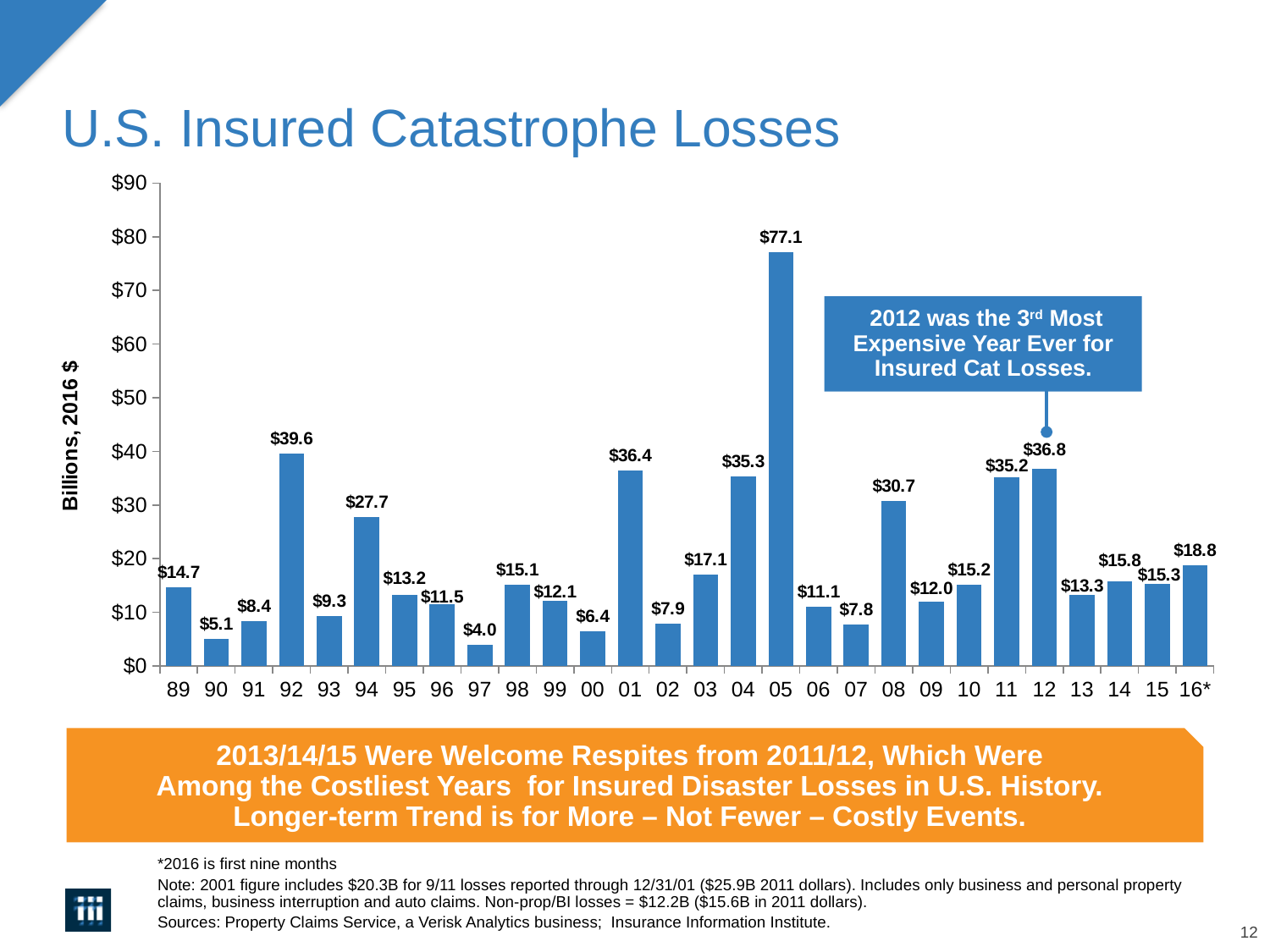
What is the value for 16* in the chart? $18.8 What is the value for 92 in the chart? $39.6 Which year has the lowest insured catastrophe losses? 97 According to the callout on the chart, which year was the 3rd most expensive year ever for insured cat losses? 2012 How many years are shown on the x axis of the chart? 28 What is the difference between the values for 12 and 11? $1.6 What is the y-axis label of the chart? Billions, 2016 $ Is the value for 08 greater or less than $30? greater Which is larger, the value for 01 or the value for 04? 01 What kind of chart is shown on the slide? bar chart Which year has the highest insured catastrophe losses? 05 What is the value for 05 in the U.S. Insured Catastrophe Losses chart? $77.1